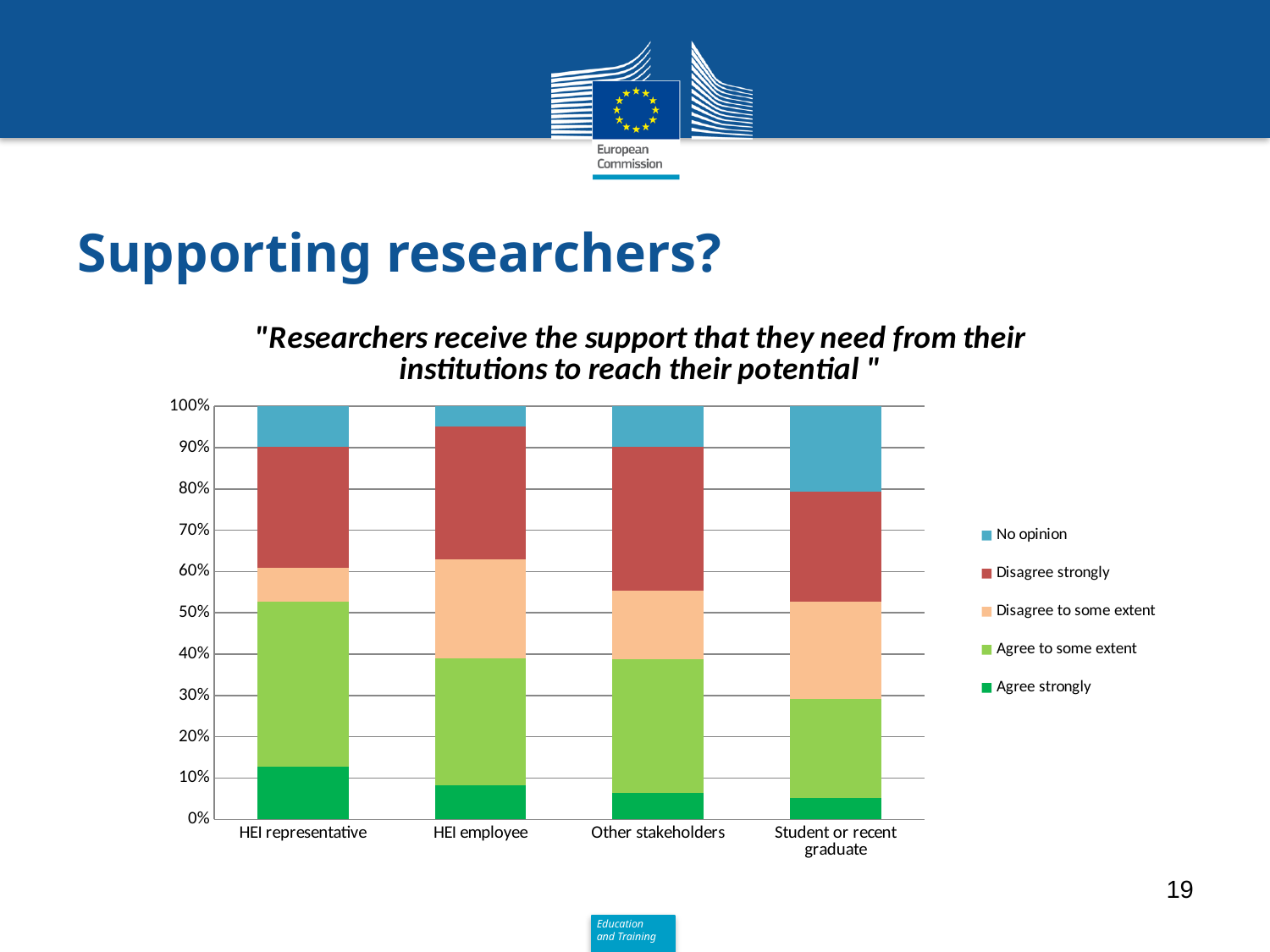
What does each stacked bar in the chart total? 100% Which category has the smallest 'No opinion' segment? HEI employee How many series does the chart's legend list? 5 Is the 'No opinion' value for Student or recent graduate greater or less than 10%? greater Is the 'Agree strongly' value for HEI employee greater or less than 10%? less What is the title of the chart? "Researchers receive the support that they need from their institutions to reach their potential " Which category has the largest 'No opinion' segment? Student or recent graduate Which category has the largest 'Agree strongly' segment? HEI representative Which is larger: the 'Agree to some extent' segment for HEI representative or for Student or recent graduate? HEI representative What kind of chart is shown on the slide? Stacked bar chart Is the 'Agree strongly' value for HEI representative greater or less than 10%? greater How many categories are shown on the x axis of the chart? 4